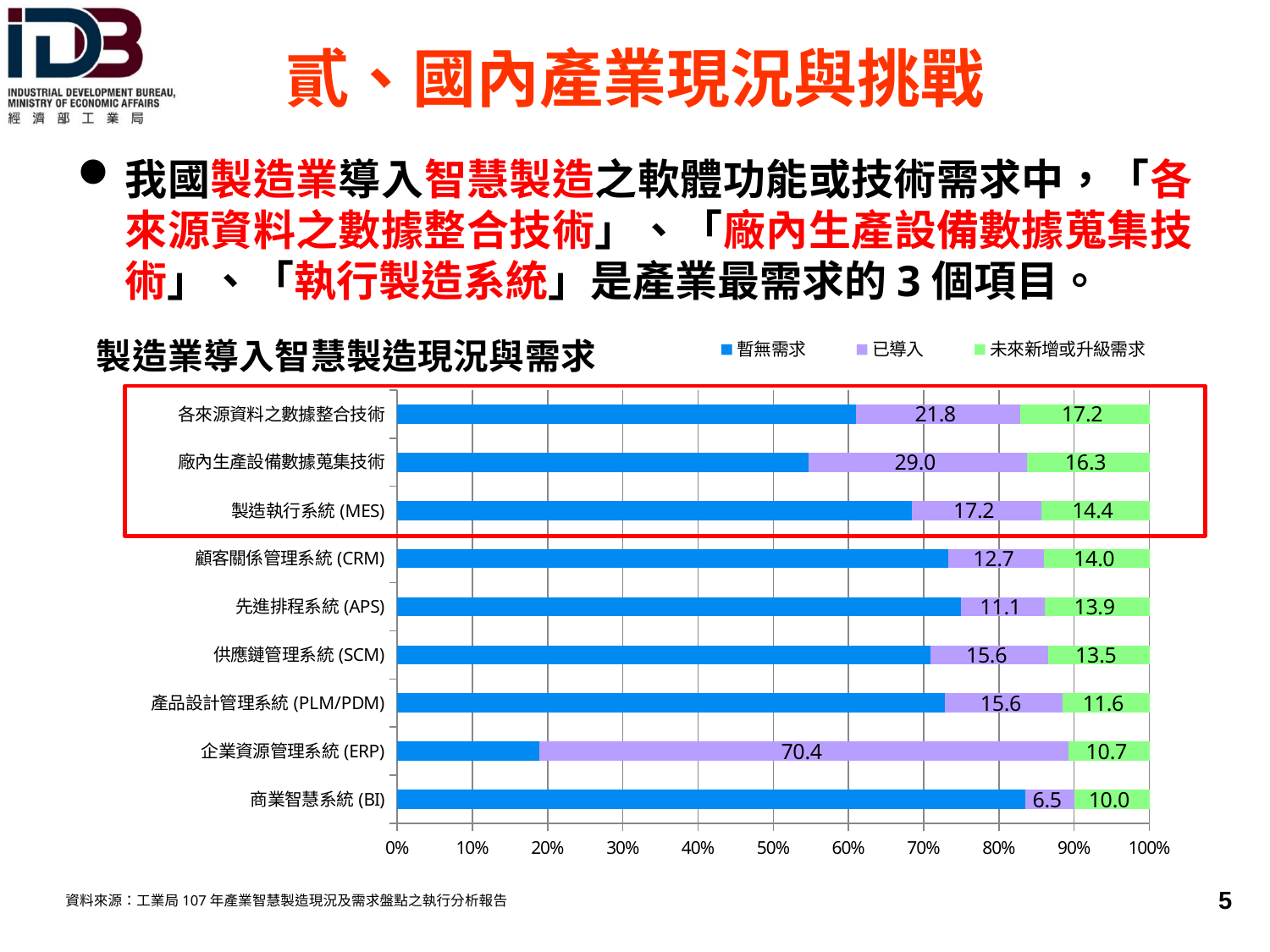
What is the 未來新增或升級需求 value for 商業智慧系統 (BI)? 10.0 How many series does the legend list? 3 Which has the larger 已導入 value, 顧客關係管理系統 (CRM) or 先進排程系統 (APS)? 顧客關係管理系統 (CRM) How many categories are shown on the chart? 9 Which category has the lowest 已導入 value? 商業智慧系統 (BI) Is the 暫無需求 value for 各來源資料之數據整合技術 greater or less than 70%? less What is the 已導入 value for 廠內生產設備數據蒐集技術? 29.0 What is the 已導入 value for 企業資源管理系統 (ERP)? 70.4 What is the 未來新增或升級需求 value for 各來源資料之數據整合技術? 17.2 Which category has the highest 已導入 value? 企業資源管理系統 (ERP) What kind of chart is shown on the slide? Stacked bar chart What is the difference between the 已導入 value and the 未來新增或升級需求 value for 製造執行系統 (MES)? 2.8